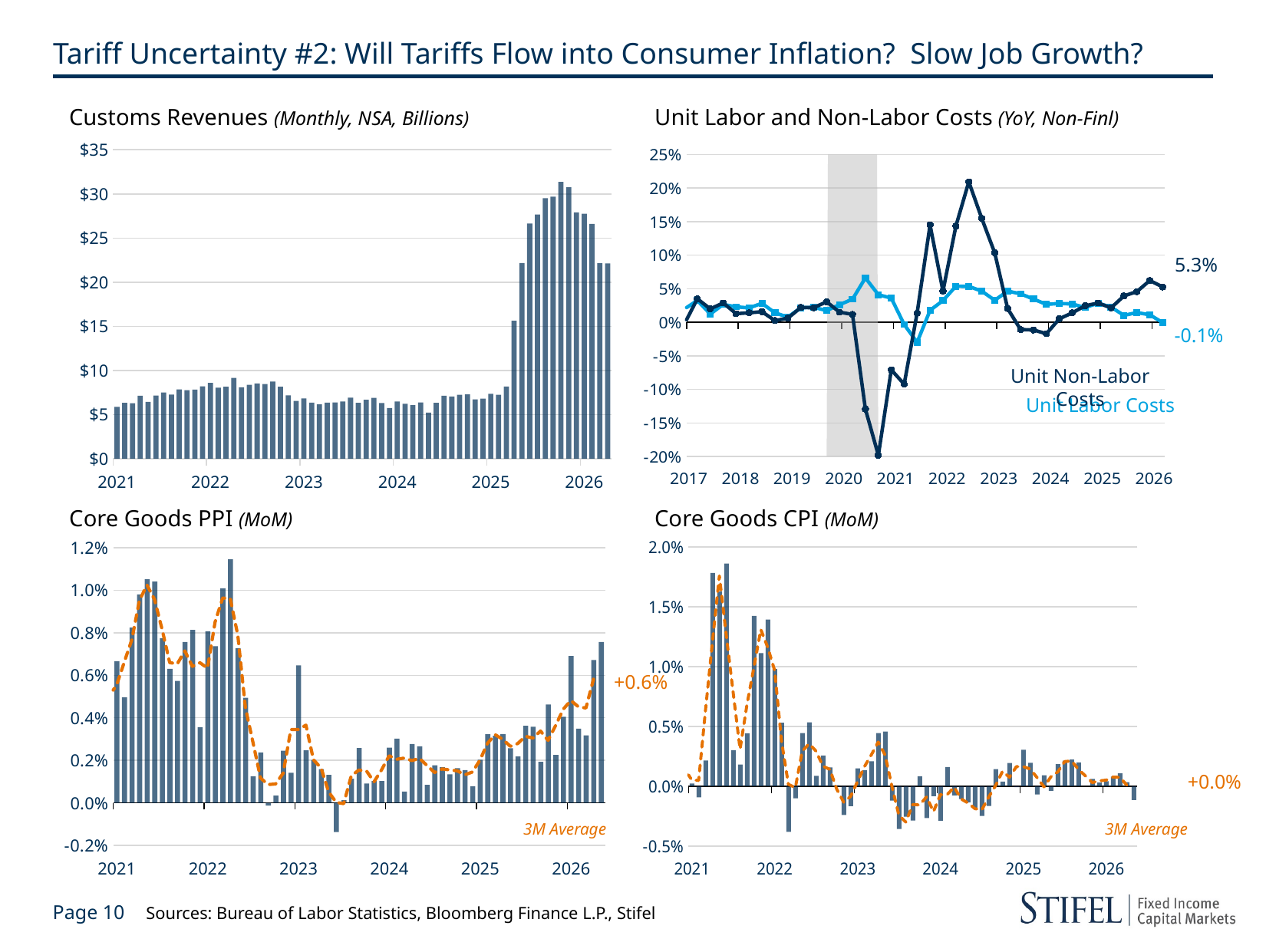
In the Customs Revenues chart, are the monthly values in 2021 greater or less than $10? less In the Customs Revenues chart, is the value of the tallest bar in late 2025 greater or less than $30? greater In the Core Goods CPI chart, what is the latest labeled value of the 3M Average line? +0.0% What kind of chart is the Customs Revenues chart at the top left? Bar chart In the Unit Labor and Non-Labor Costs chart, which series has the higher latest labeled value, Unit Non-Labor Costs or Unit Labor Costs? Unit Non-Labor Costs How many series does the Unit Labor and Non-Labor Costs chart show? 2 In the Core Goods PPI chart, what is the latest labeled value of the 3M Average line? +0.6% In the Core Goods PPI chart, is the tallest bar in 2022 greater or less than 1.0%? greater In the Unit Labor and Non-Labor Costs chart, what is the latest labeled value for Unit Labor Costs? -0.1% In the Unit Labor and Non-Labor Costs chart, what is the latest labeled value for Unit Non-Labor Costs? 5.3%